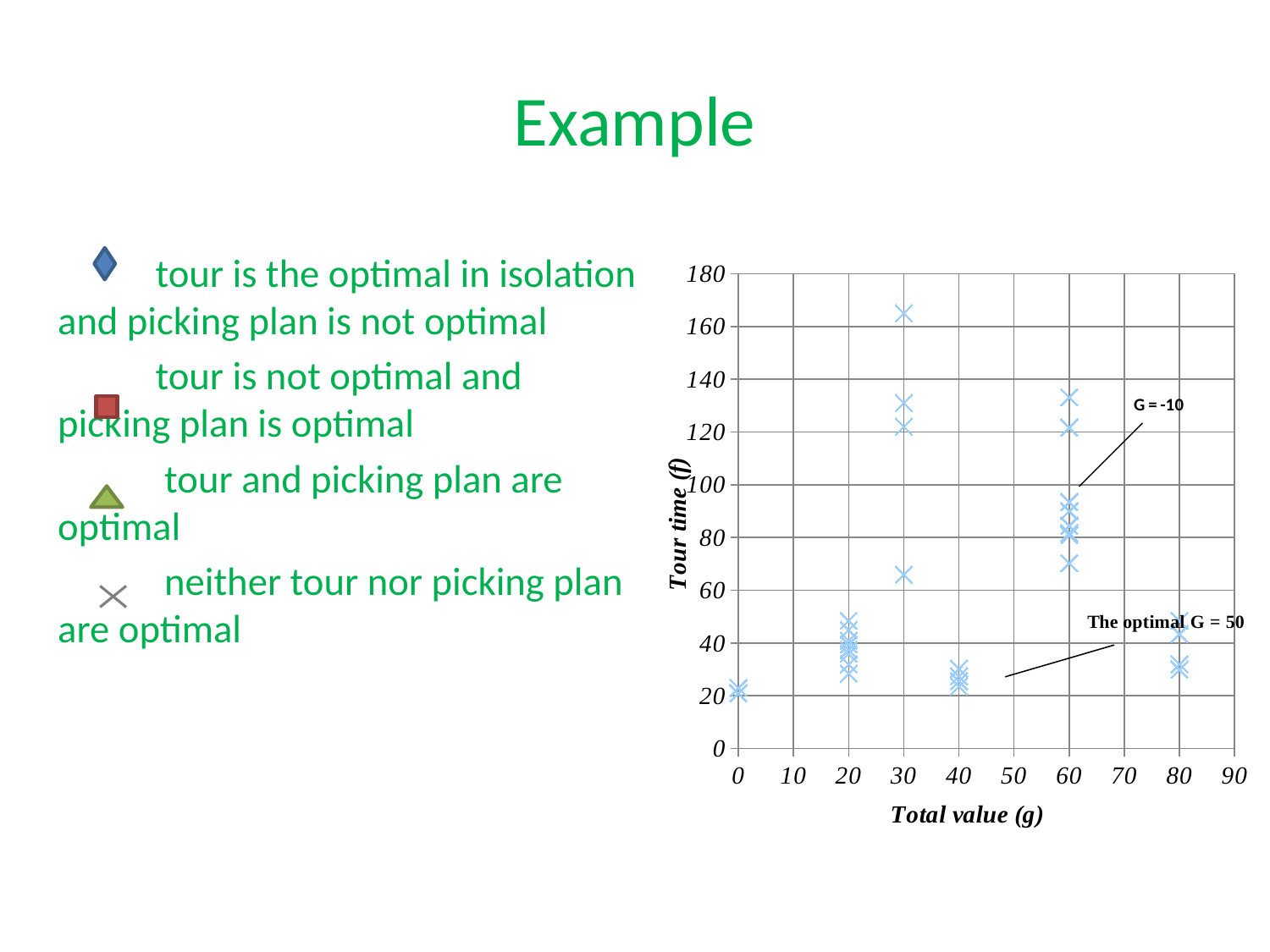
Are the tour times of the points at total value 40 greater or less than 40? less What is the title of the x axis of the chart? Total value (g) What kind of chart is shown on the slide? scatter chart At which total value (g) does the point with the highest tour time appear? 30 Is the tour time of the highest point at total value 30 greater or less than 160? greater What is the maximum value shown on the y axis of the chart? 180 What is the title of the y axis of the chart? Tour time (f) Is the tour time of the lowest point at total value 60 greater or less than 60? greater How many distinct total value (g) positions have plotted points in the chart? 6 Which has the higher tour time: the highest point at total value 30 or the highest point at total value 60? the highest point at total value 30